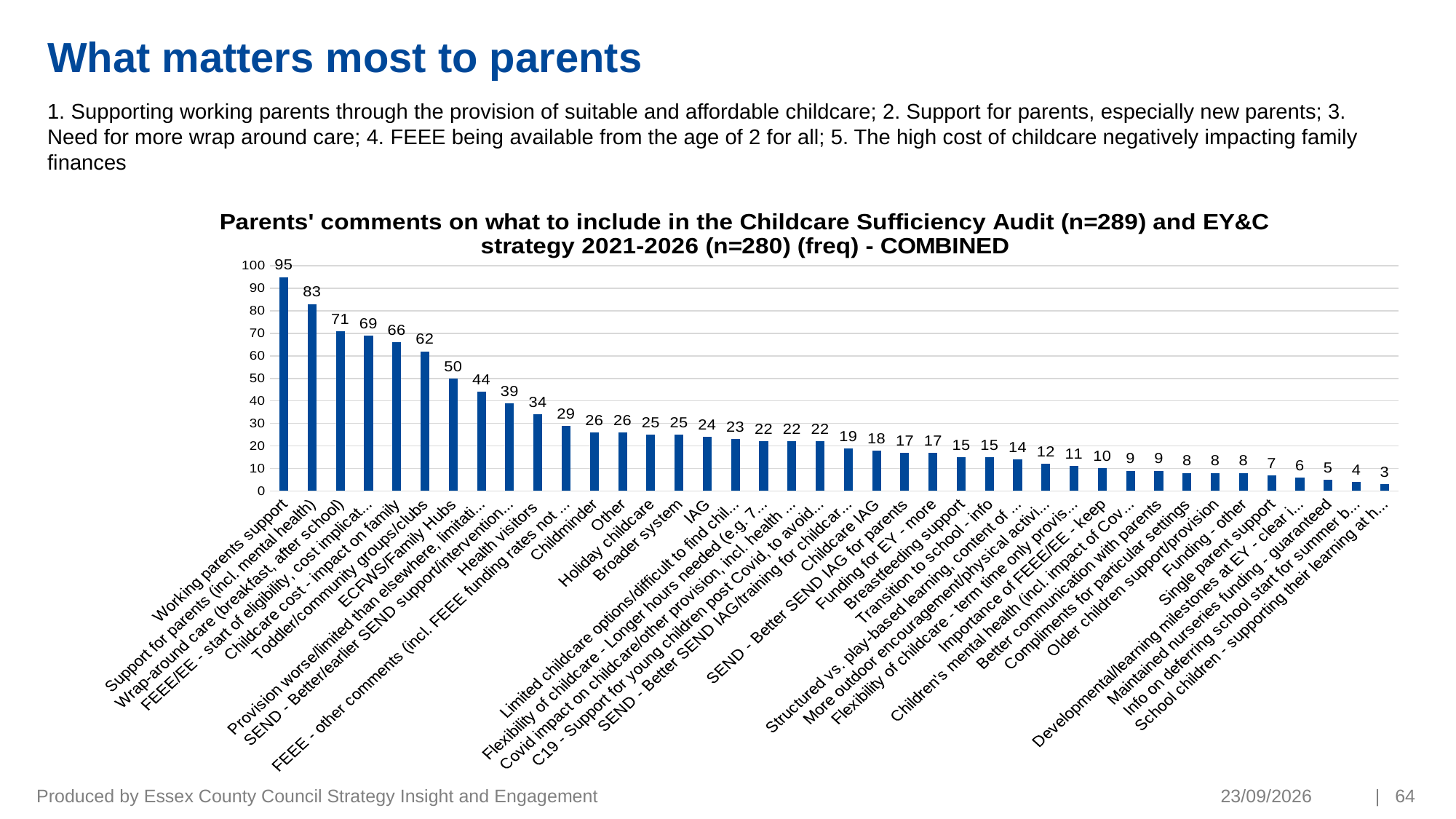
What is the difference between the values for Working parents support and Support for parents (incl. mental health)? 12 Which category has the highest value? Working parents support Is the value for Childcare cost - impact on family greater or less than 60? greater Do the values rise or fall from left to right along the x axis? Fall What kind of chart is shown on the slide? Bar chart What is the value for Childminder? 26 What is the value for Working parents support? 95 How many bars are plotted in the chart? 40 Which is larger, the value for ECFWS/Family Hubs or the value for Toddler/community groups/clubs? Toddler/community groups/clubs What is the value for Breastfeeding support? 15 What is the value for Health visitors? 34 Which category has the lowest value? School children - supporting their learning at h...